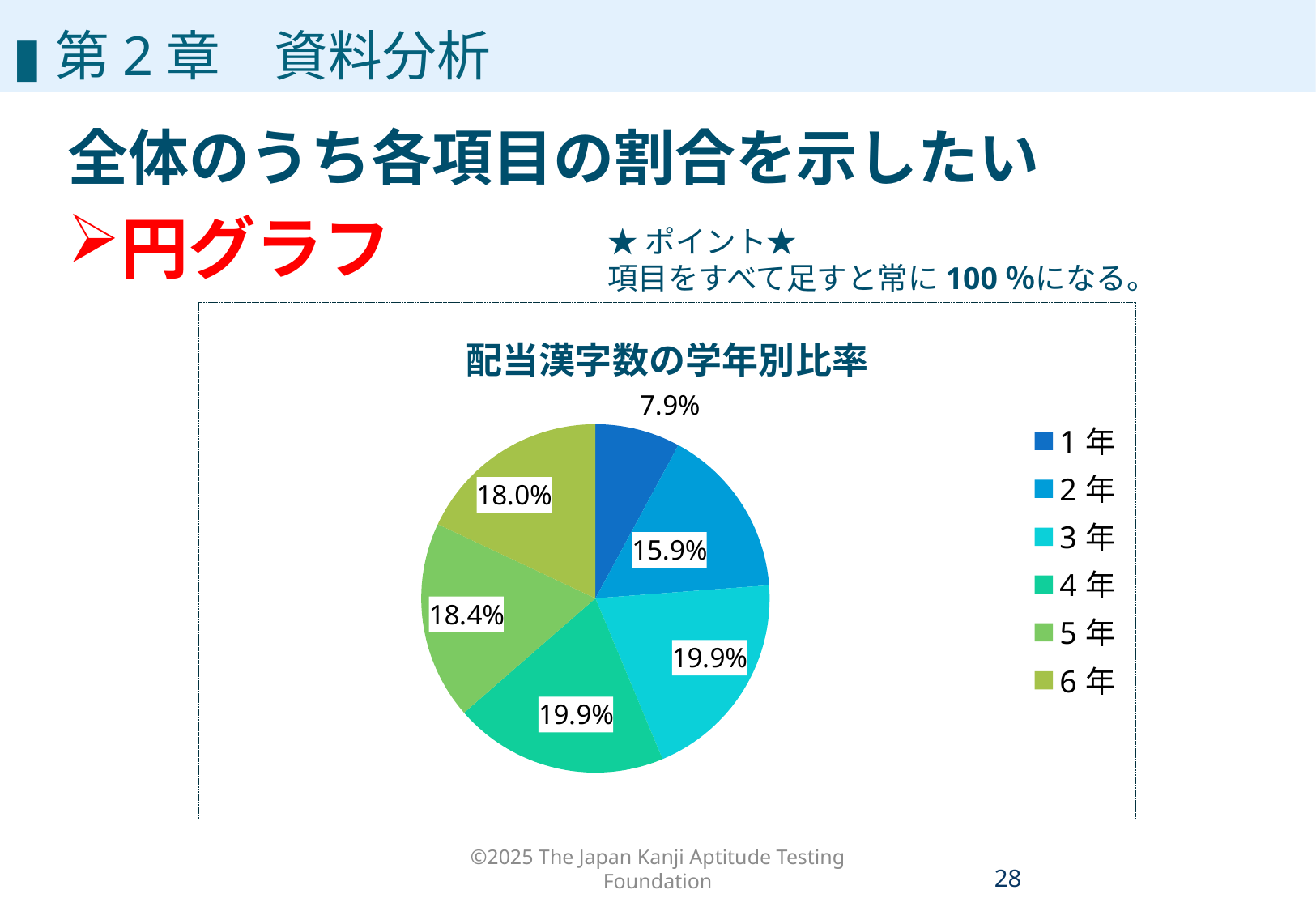
What kind of chart is shown on the slide? pie chart What is the share for 1年 in the pie chart? 7.9% How many slices does the pie chart have? 6 What is the difference in percentage points between the shares for 2年 and 1年? 8.0 What is the share for 6年 in the pie chart? 18.0% How many entries does the legend of the pie chart list? 6 What is the share for 2年 in the pie chart? 15.9% What is the title of the pie chart? 配当漢字数の学年別比率 Which has the larger share, 5年 or 6年? 5年 What is the share for 5年 in the pie chart? 18.4% What is the combined share of 3年 and 4年 in the pie chart? 39.8% Which grade has the smallest slice in the pie chart? 1年